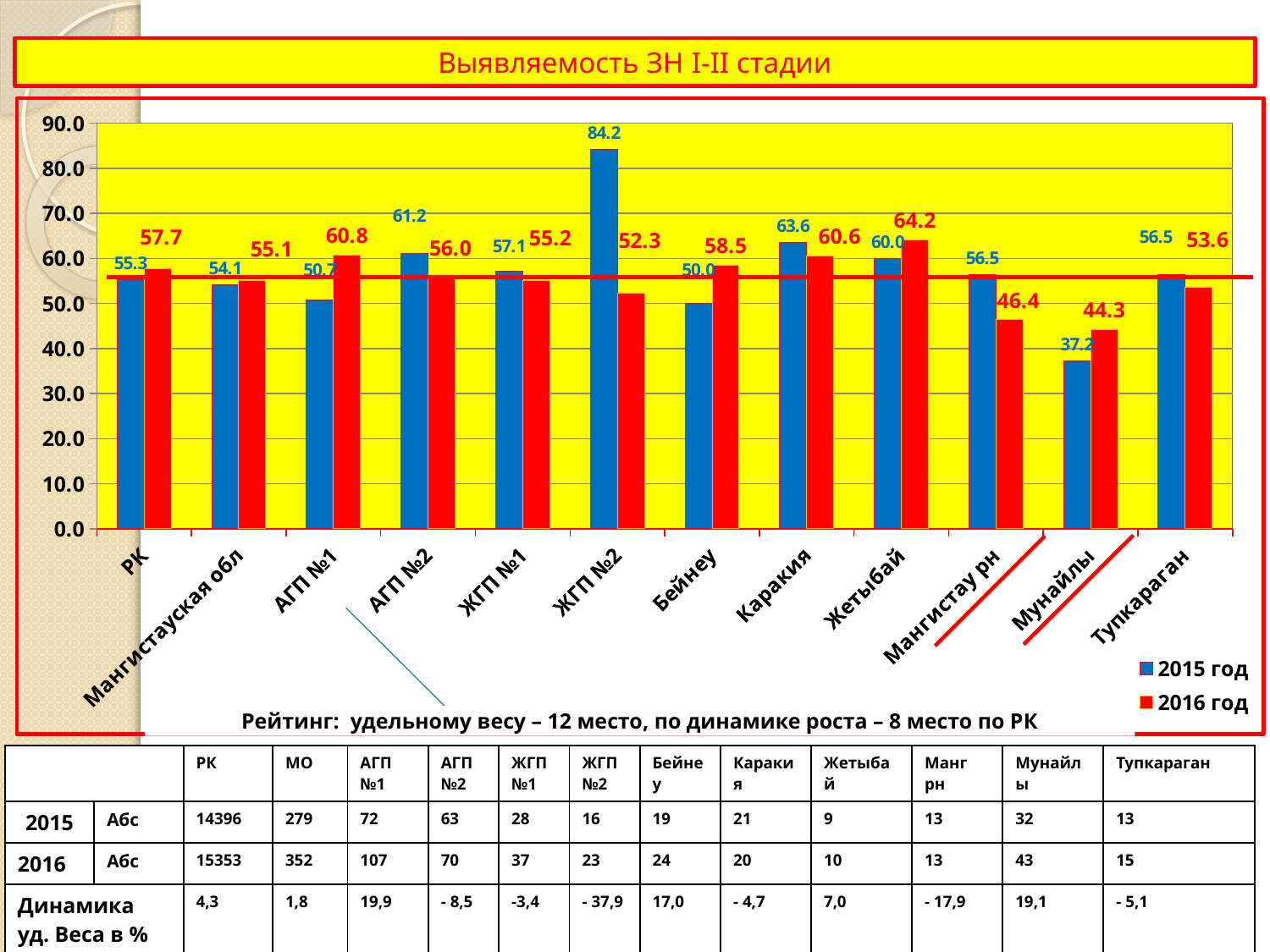
What is the 2015 год value for ЖГП №2? 84.2 What is the 2016 год value for Мунайлы? 44.3 How many categories are shown on the x axis of the chart? 12 Which category has the lowest 2016 год value? Мунайлы What kind of chart is shown on the slide? bar chart What is the difference between the 2016 год and 2015 год values for АГП №1? 10.1 Which is larger for Мангистау рн: the 2015 год value or the 2016 год value? 2015 год What is the 2016 год value for Жетыбай? 64.2 How many series does the legend list? 2 Is the 2015 год value for Мунайлы greater or less than 40.0? less Which category has the highest 2015 год value? ЖГП №2 What is the title of the chart? Выявляемость ЗН I-II стадии